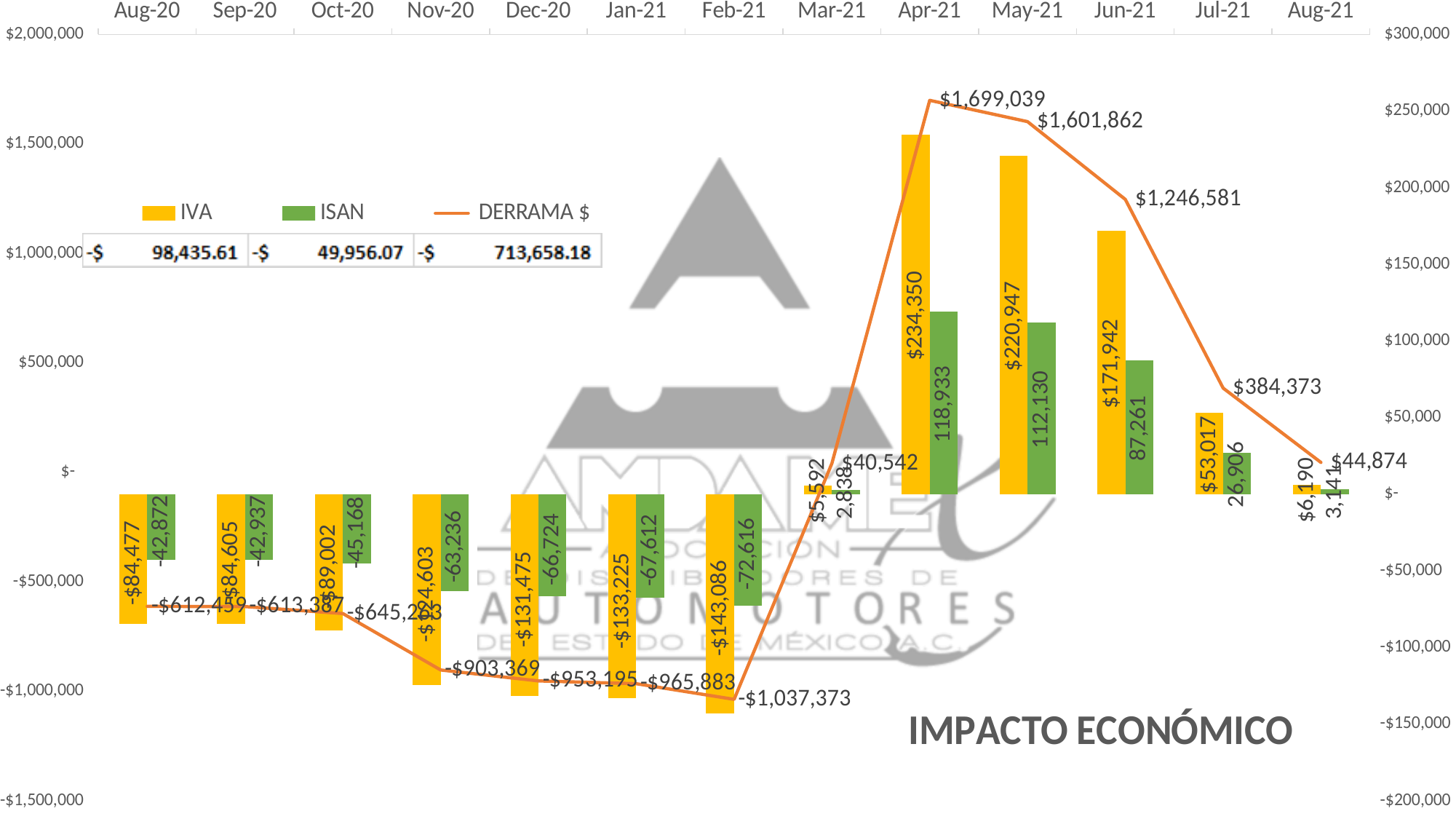
How many series does the legend list? 3 Which month has the larger IVA value, Jun-21 or Jul-21? Jun-21 What is the DERRAMA $ value for Jul-21? $384,373 What kind of chart is this? Combination bar and line chart What is the DERRAMA $ value for Feb-21? -$1,037,373 What is the IVA value for Apr-21? $234,350 In which month does DERRAMA $ reach its highest value? Apr-21 In which month is the IVA value lowest? Feb-21 What is the difference between the IVA values for Apr-21 and May-21? $13,403 Does the DERRAMA $ line rise or fall from Apr-21 to Aug-21? Fall How many months are shown on the x axis? 13 What is the ISAN value for May-21? 112,130